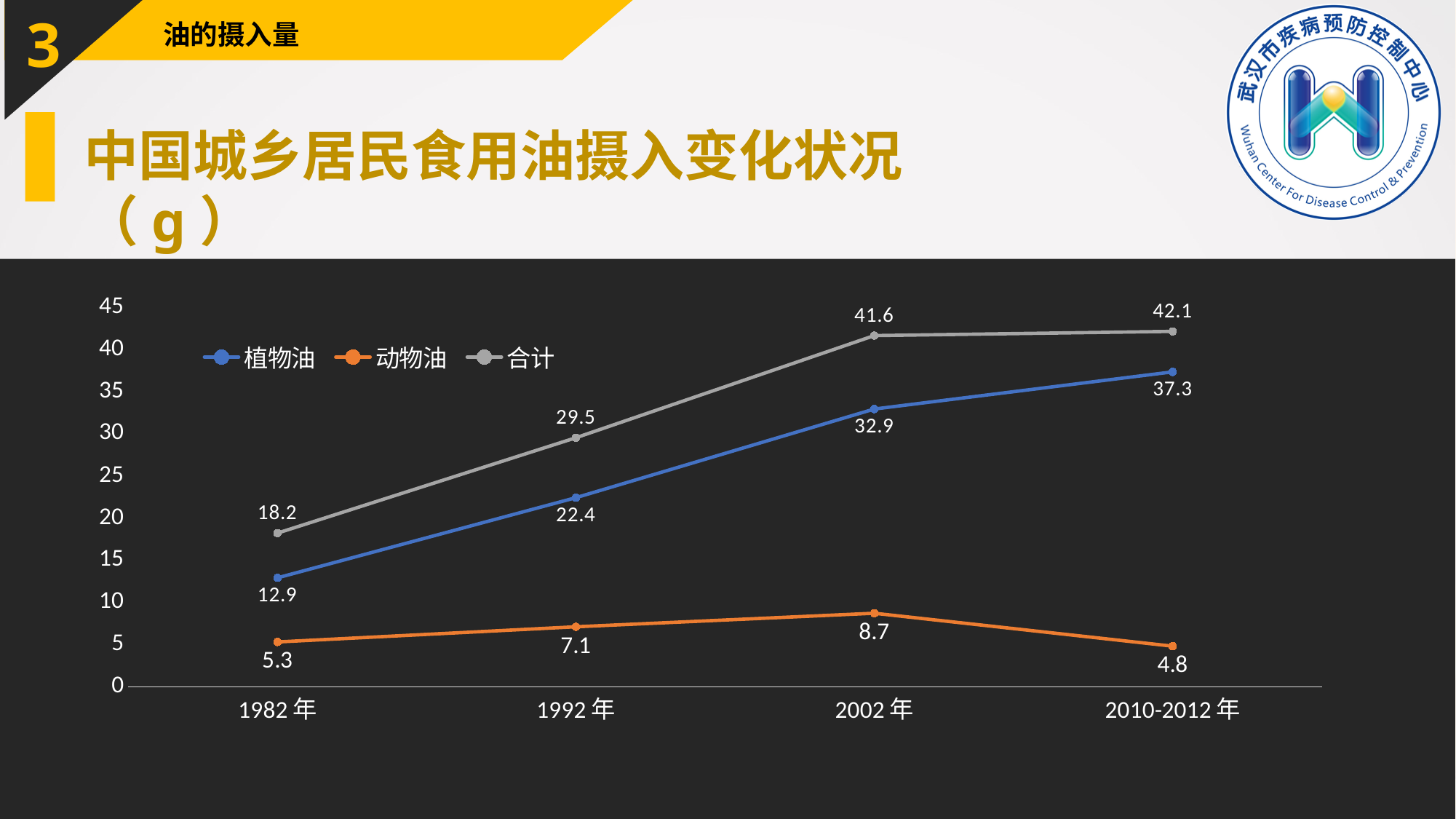
Which is larger, the 动物油 value in 1982年 or in 2010-2012年? 1982年 In which year is the 植物油 value lowest? 1982年 Does the 植物油 series rise or fall from 1982年 to 2010-2012年? rise How many series does the legend list? 3 What is the value for 植物油 in 1992年? 22.4 How many time points are shown on the x axis? 4 What is the value for 动物油 in 2002年? 8.7 Which colour is used for the 合计 series? grey What is the difference between the 合计 values for 2002年 and 1992年? 12.1 What is the value for 合计 in 2010-2012年? 42.1 In which year is the 动物油 value highest? 2002年 What kind of chart is shown on the slide? line chart